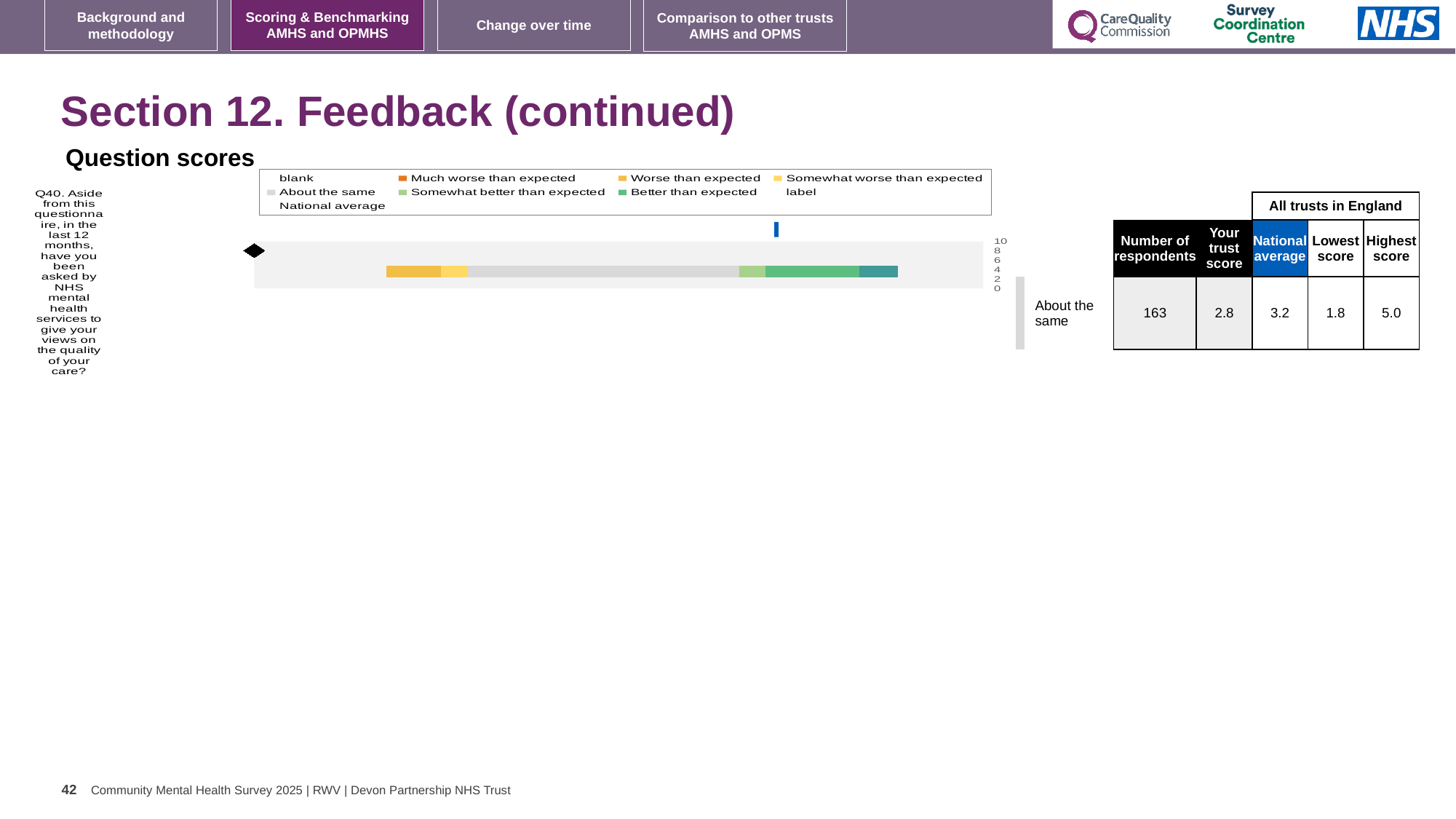
In the Question scores chart legend, which entry is shown in orange? Much worse than expected In the table beside the Question scores chart, what is the National average for Q40? 3.2 In the table beside the Question scores chart, which is larger for Q40: Your trust score or the National average? National average What kind of chart is shown under 'Question scores'? bar chart Which question is plotted in the Question scores chart? Q40. Aside from this questionnaire, in the last 12 months, have you been asked by NHS mental health services to give your views on the quality of your care? In the table beside the Question scores chart, what is the Highest score for Q40? 5.0 How many questions (categories) are plotted in the Question scores chart? 1 How many entries does the legend of the Question scores chart list? 9 In the table beside the Question scores chart, what is 'Your trust score' for Q40? 2.8 What rating label is shown to the right of the bar for Q40 in the Question scores chart? About the same In the table beside the Question scores chart, what is the number of respondents for Q40? 163 In the table beside the Question scores chart, what is the difference between the Highest score and the Lowest score for Q40? 3.2